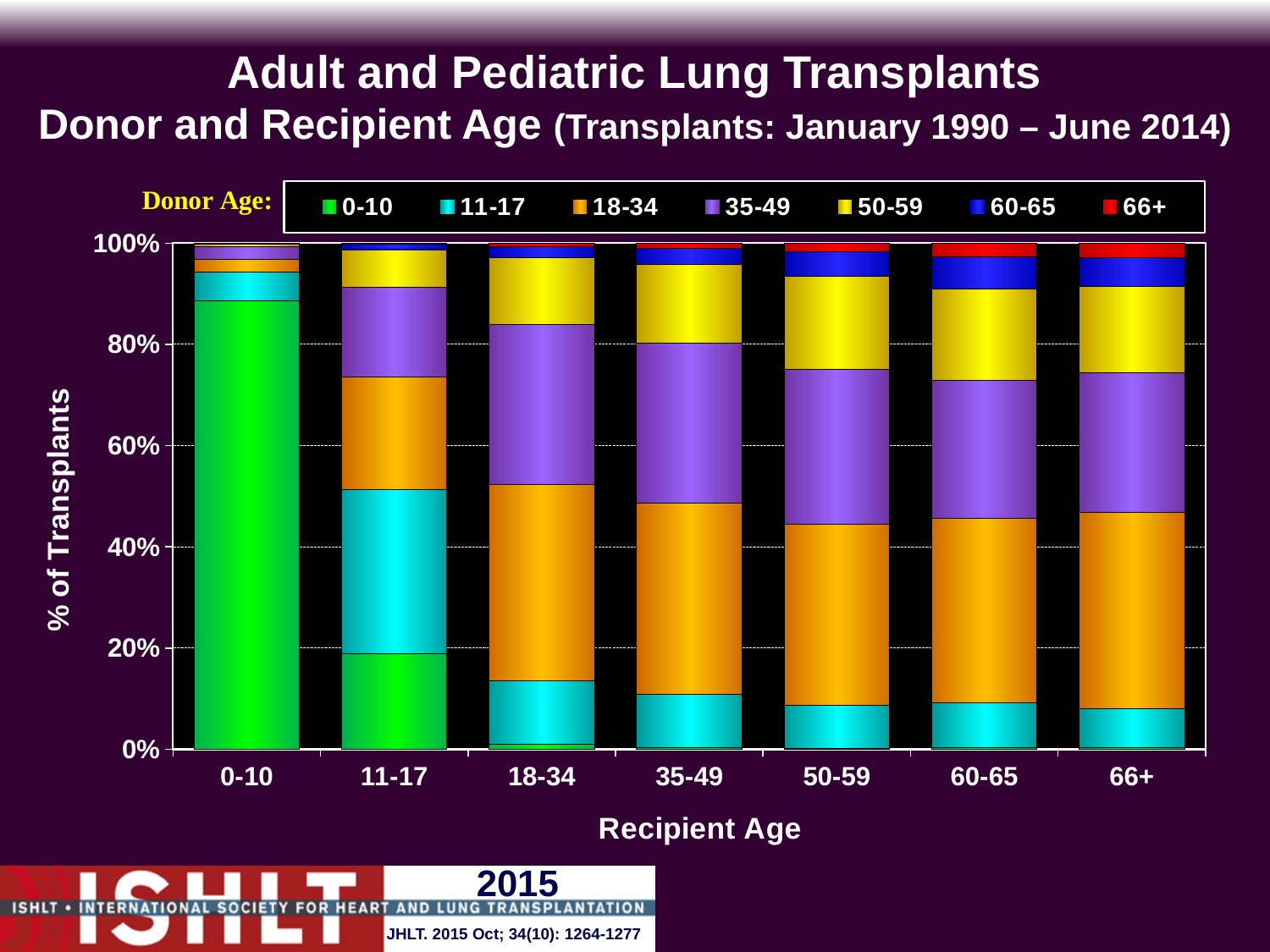
What label appears to the left of the legend? Donor Age: For recipients aged 0-10, which donor age group accounts for a larger share: 0-10 or 11-17? 0-10 What kind of chart is shown on the slide? Stacked bar chart Which recipient age group has the largest share of transplants from donors aged 0-10? 0-10 As recipient age increases along the x axis, does the share of transplants from donors aged 0-10 rise or fall? fall Which recipient age group has the largest share of transplants from donors aged 11-17? 11-17 For recipients aged 18-34, which donor age group accounts for a larger share: 18-34 or 35-49? 18-34 How many recipient age categories are shown on the x axis? 7 How many donor age groups does the legend list? 7 Is the share of transplants from donors aged 0-10 for recipients aged 0-10 greater or less than 80%? greater Is the share of transplants from donors aged 11-17 for recipients aged 11-17 greater or less than 20%? greater What is the label of the y axis? % of Transplants